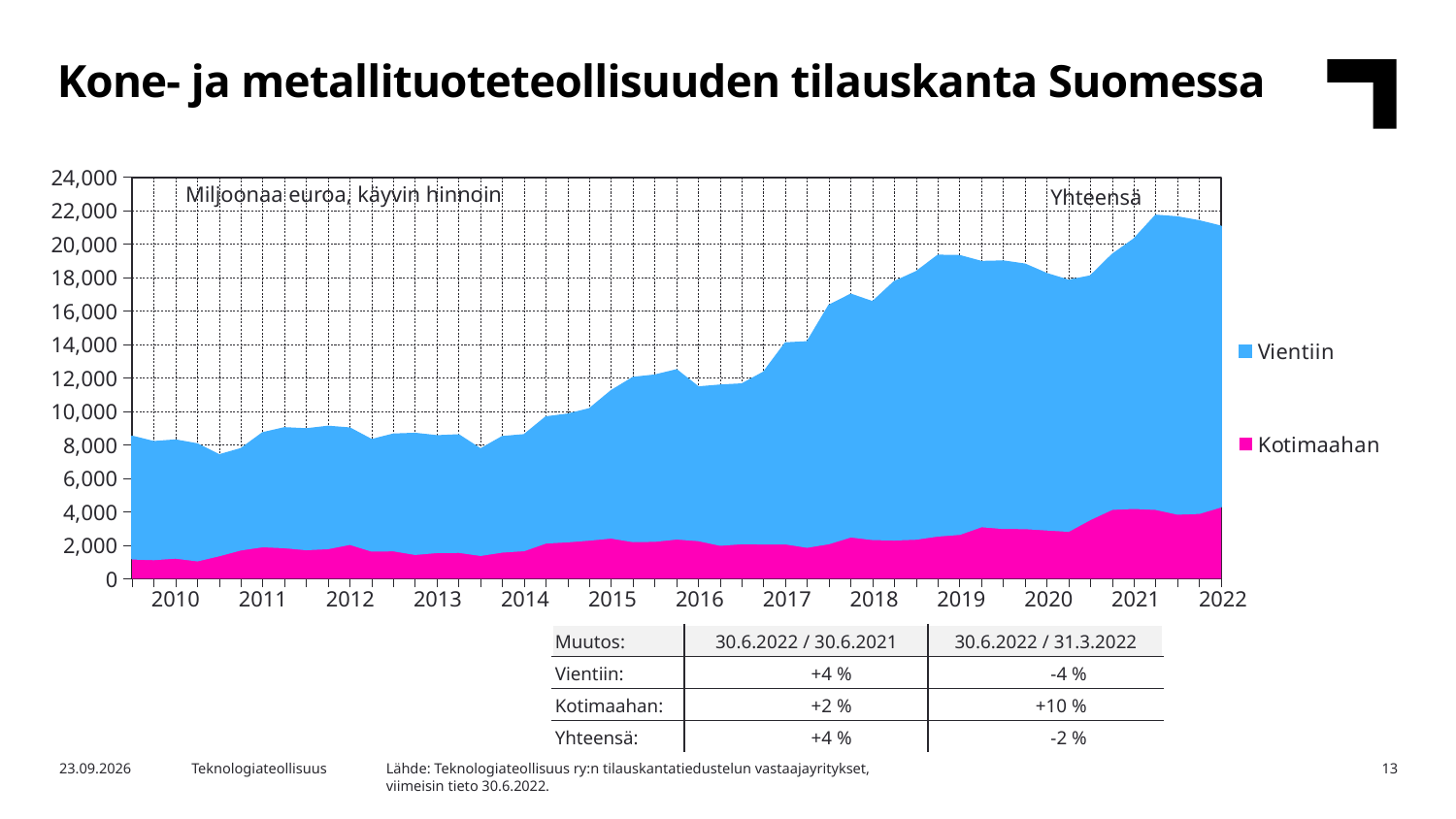
Is the Kotimaahan value at the start of 2010 greater or less than 2,000? less How many year labels are shown on the x axis? 13 Is the total order book (Yhteensä) at the start of 2010 greater or less than 10,000? less Is the total order book higher in 2019 or in 2015? 2019 What unit is stated in the label inside the chart area? Miljoonaa euroa, käyvin hinnoin What are the two series named in the chart legend? Vientiin and Kotimaahan What kind of chart is shown on the slide? Stacked area chart Does the total order book generally rise or fall from 2010 to 2022? rise In which year does the total order book (Yhteensä) reach its highest level? 2021 How many series does the chart legend list? 2